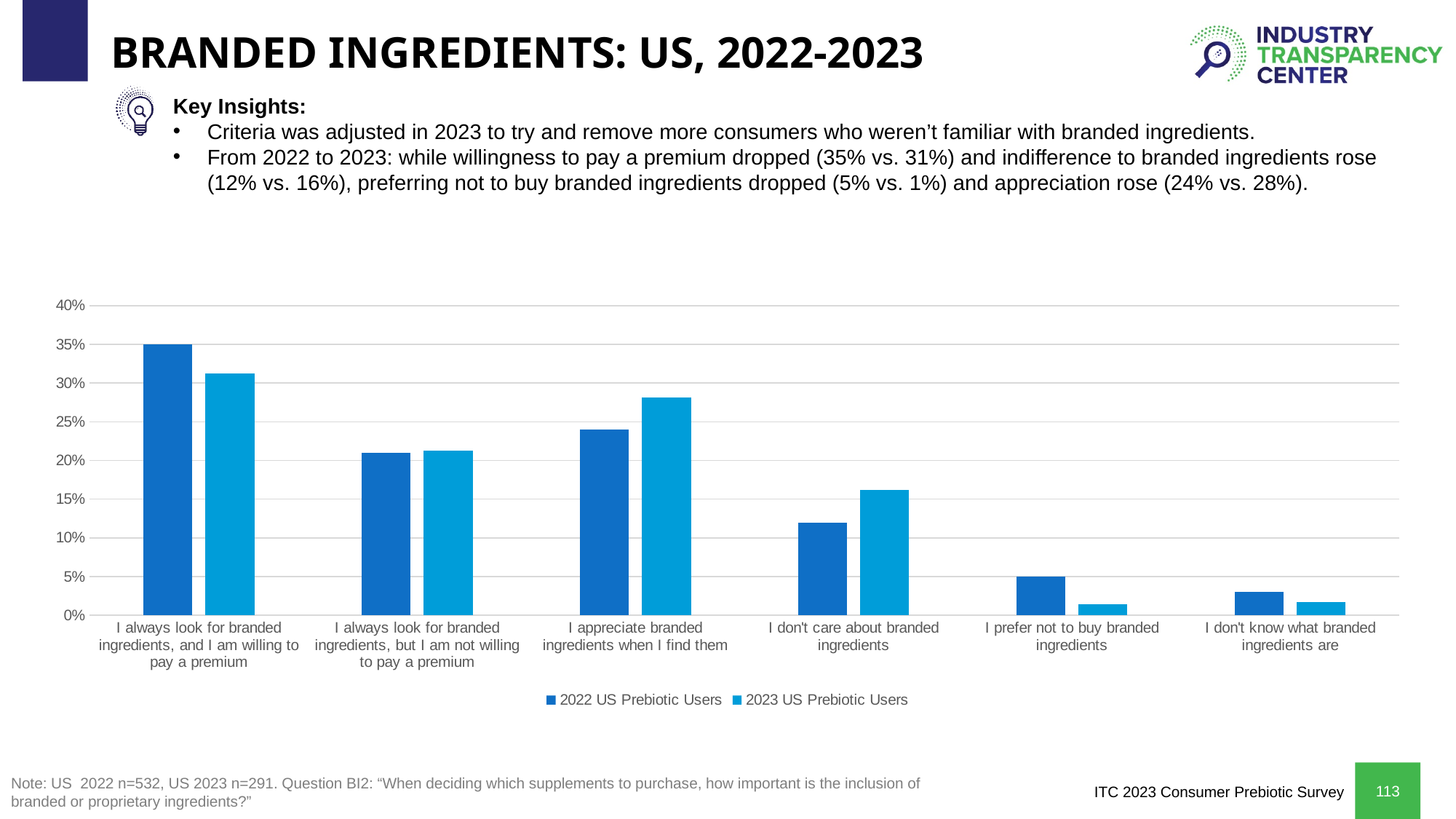
How many series does the legend list? 2 For 'I always look for branded ingredients, and I am willing to pay a premium', which series has the larger value, 2022 US Prebiotic Users or 2023 US Prebiotic Users? 2022 US Prebiotic Users Is the value for 2022 US Prebiotic Users for 'I don't care about branded ingredients' greater or less than 15%? less How many categories are shown along the x axis? 6 Is the value for 2023 US Prebiotic Users for 'I appreciate branded ingredients when I find them' greater or less than 25%? greater What kind of chart is shown on the slide? bar chart Which category has the lowest value for 2022 US Prebiotic Users? I don't know what branded ingredients are For 'I appreciate branded ingredients when I find them', which series has the larger value, 2022 US Prebiotic Users or 2023 US Prebiotic Users? 2023 US Prebiotic Users What are the two series named in the chart legend? 2022 US Prebiotic Users and 2023 US Prebiotic Users What is the value for 2022 US Prebiotic Users for 'I prefer not to buy branded ingredients'? 5% What is the value for 2022 US Prebiotic Users for 'I always look for branded ingredients, and I am willing to pay a premium'? 35% Which category has the highest value for 2022 US Prebiotic Users? I always look for branded ingredients, and I am willing to pay a premium